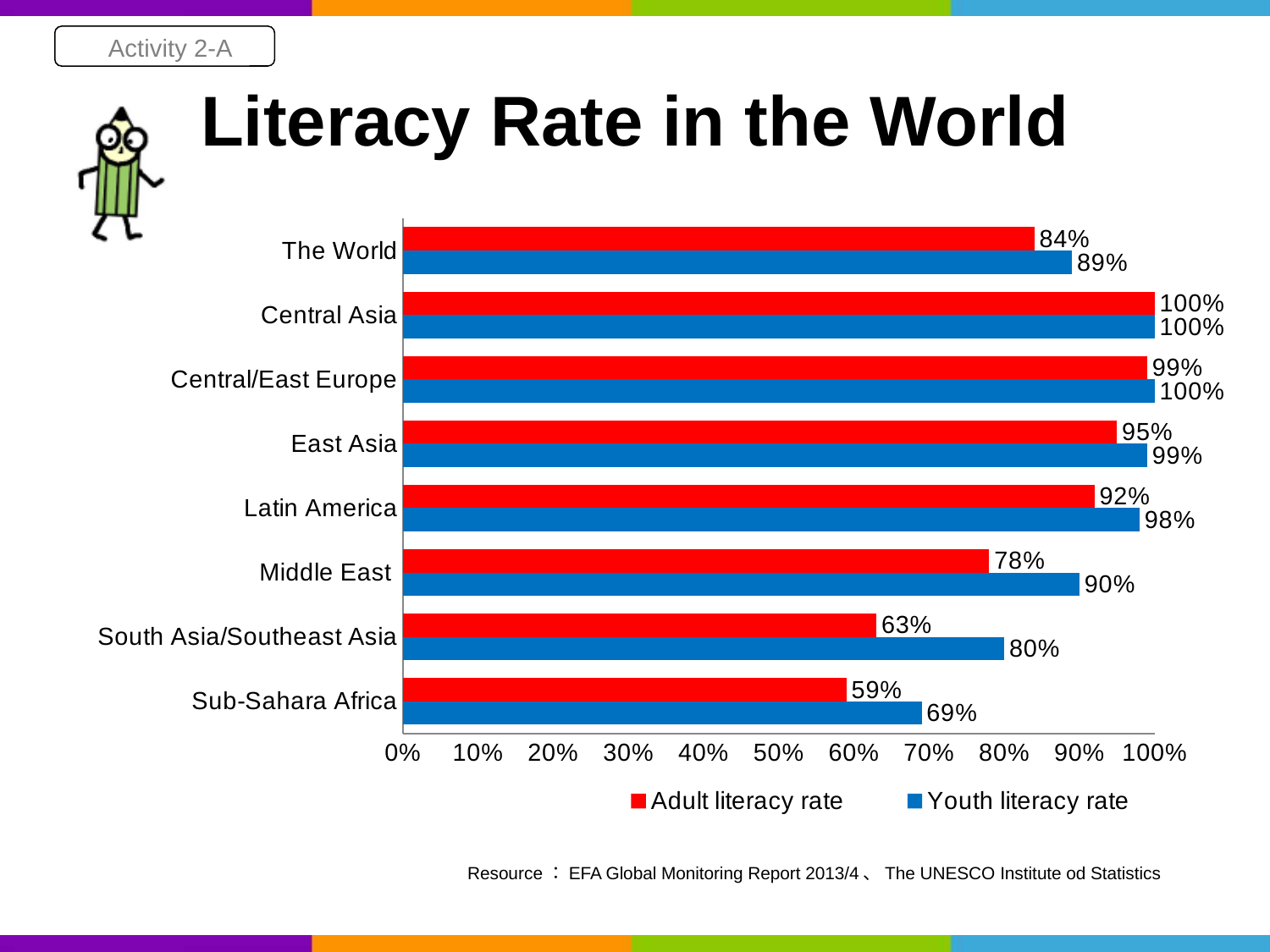
How many series does the legend list? 2 How many regions (categories) are shown on the chart? 8 Which region has the lowest adult literacy rate? Sub-Sahara Africa Which region has the lowest youth literacy rate? Sub-Sahara Africa Which colour represents the youth literacy rate in the chart? Blue Is the youth literacy rate for Sub-Sahara Africa greater or less than 60%? greater What is the adult literacy rate for The World? 84% Which is larger, the adult literacy rate for Latin America or the adult literacy rate for the Middle East? Latin America What is the adult literacy rate for Sub-Sahara Africa? 59% What is the youth literacy rate for the Middle East? 90% What is the difference between the youth and adult literacy rates for South Asia/Southeast Asia? 17% What kind of chart is shown on the slide? Bar chart